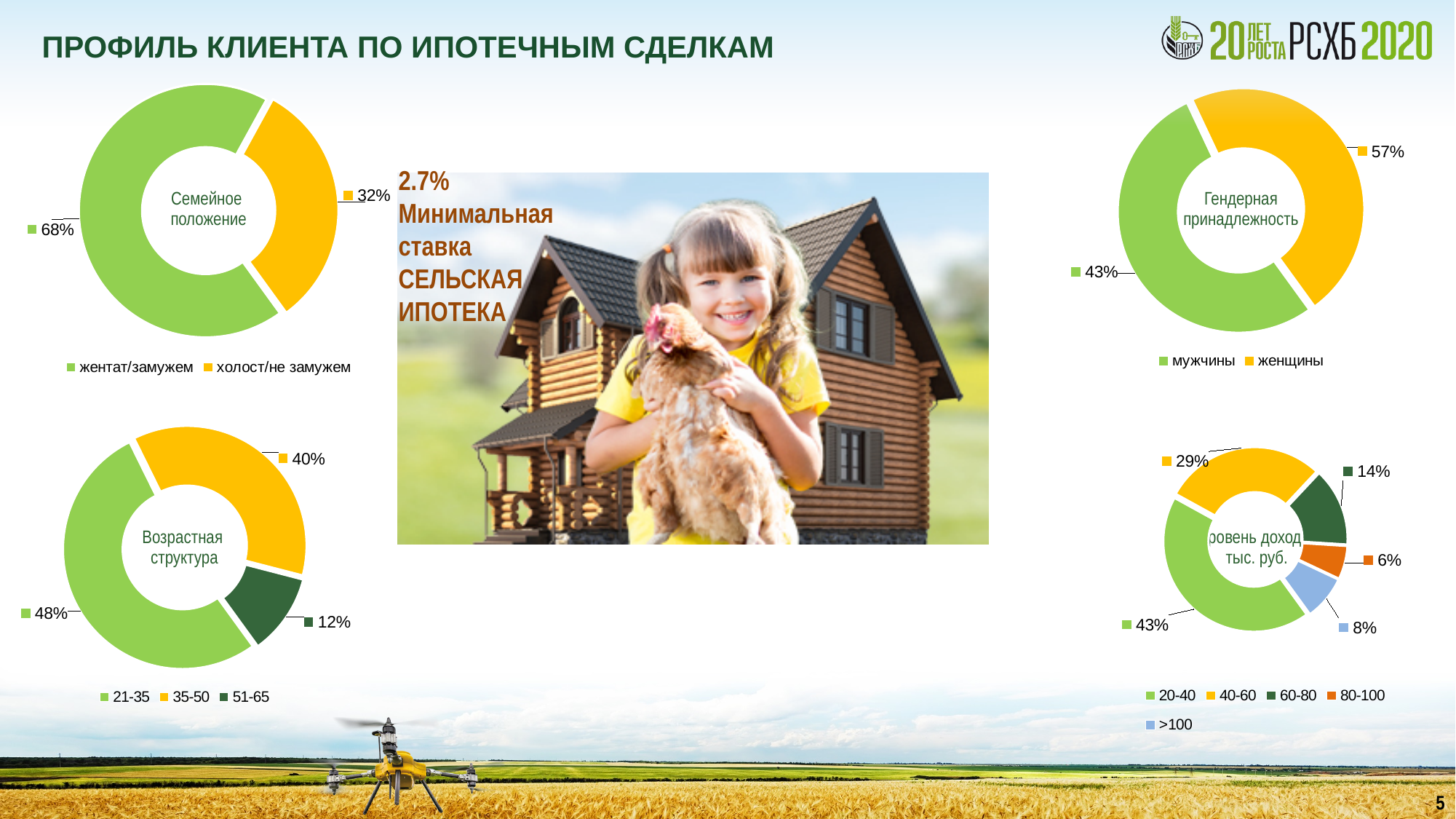
In the 'Семейное положение' chart, what share is labelled for 'женат/замужем'? 68% In the 'Возрастная структура' chart, which age group has the smallest share? 51-65 In the 'Гендерная принадлежность' chart, what share is labelled for 'женщины'? 57% In the 'Гендерная принадлежность' chart, which category has the larger share, 'мужчины' or 'женщины'? женщины In the 'Возрастная структура' chart, what is the difference between the shares for '21-35' and '51-65'? 36% In the 'Уровень дохода, тыс. руб.' chart, what share is labelled for the '60-80' category? 14% What type of chart is the 'Возрастная структура' chart? Donut (pie) chart In the 'Уровень дохода, тыс. руб.' chart, which category has the largest share? 20-40 In the 'Уровень дохода, тыс. руб.' chart, which category has the smallest share? 80-100 How many categories does the legend of the 'Уровень дохода, тыс. руб.' chart list? 5 In the 'Возрастная структура' chart, what share is labelled for the '35-50' age group? 40% In the 'Семейное положение' chart, what share is labelled for 'холост/не замужем'? 32%